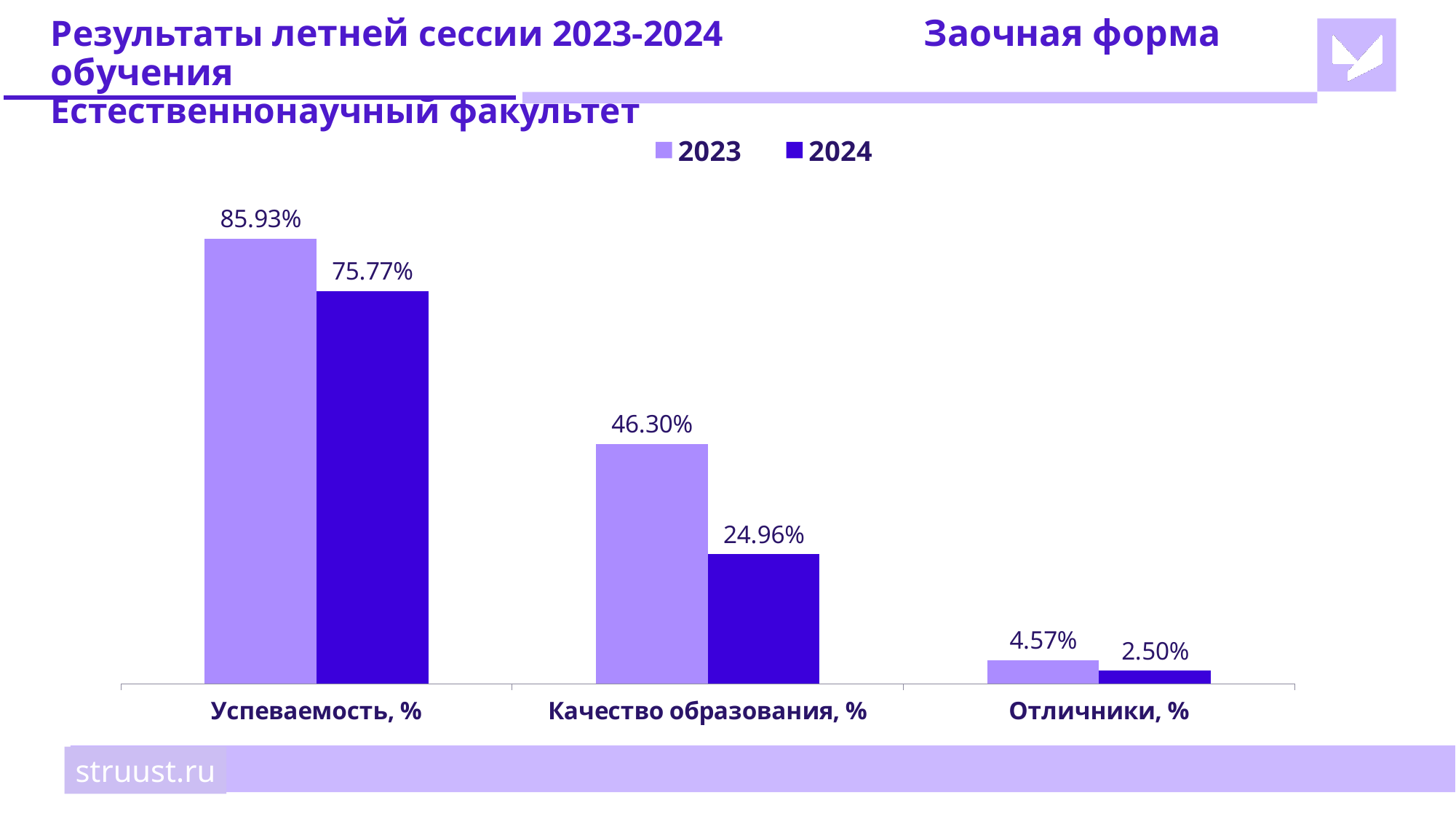
What is the 2024 value for Качество образования, %? 24.96% What is the 2023 value for Качество образования, %? 46.30% What is the 2023 value for Успеваемость, %? 85.93% Which category has the lowest 2023 value? Отличники, % Which is larger for Отличники, %: the 2023 value or the 2024 value? 2023 What is the difference between the 2023 and 2024 values for Качество образования, %? 21.34% What is the difference between the 2023 and 2024 values for Успеваемость, %? 10.16% What kind of chart is shown on the slide? Bar chart What is the 2024 value for Отличники, %? 2.50% Which category has the highest 2024 value? Успеваемость, % How many categories are shown on the x axis? 3 How many series does the legend list? 2